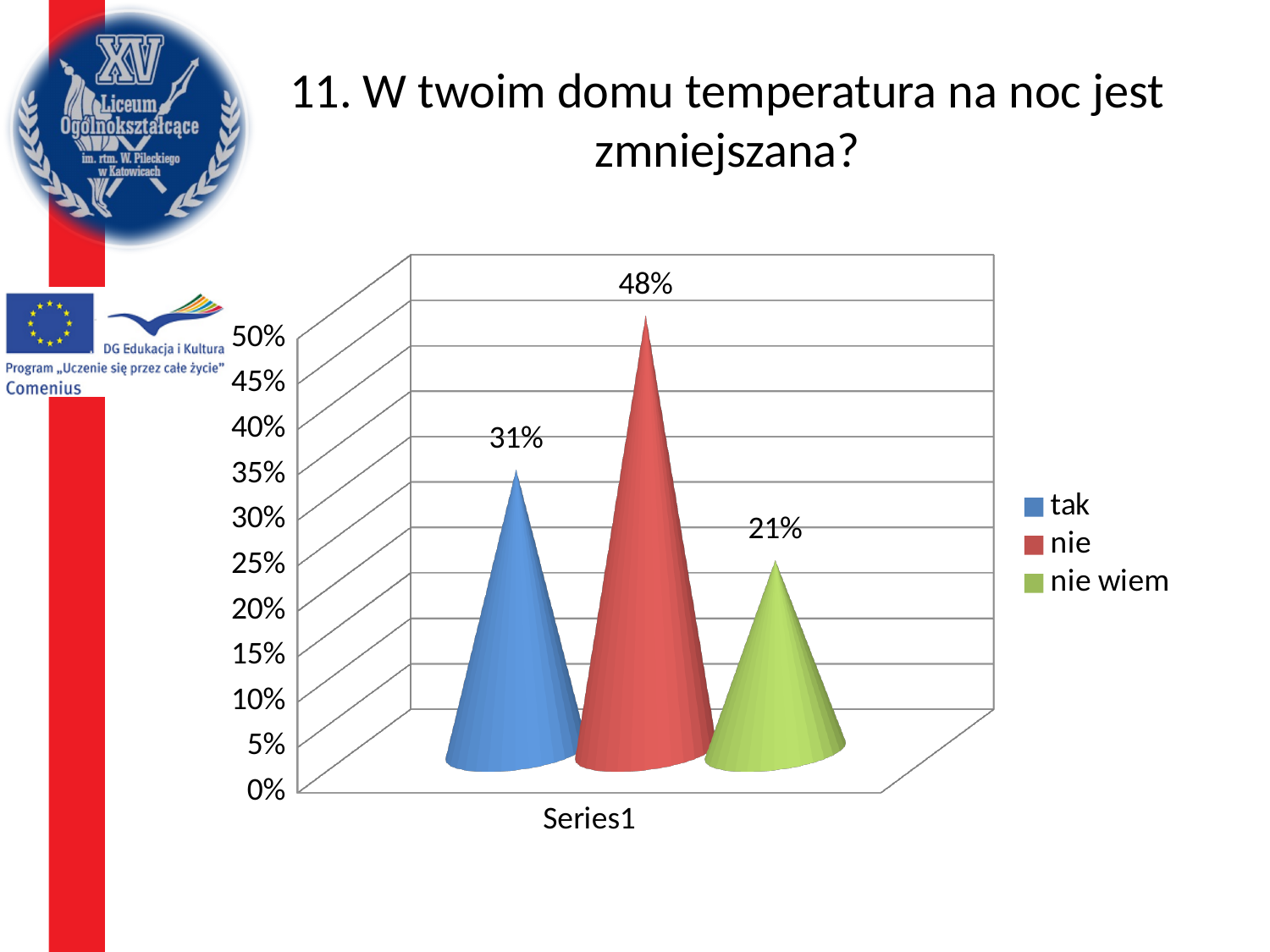
What is the difference between the values for "tak" and "nie wiem"? 10% What is the value for "tak"? 31% What is the value for "nie"? 48% Which answer has the lowest value? nie wiem What is the value for "nie wiem"? 21% Which is larger, the value for "tak" or the value for "nie wiem"? tak What kind of chart is shown on the slide? bar chart What colour is the cone for "nie"? red Is the value for "nie" greater or less than 40%? greater How many entries does the legend list? 3 Which answer has the highest value? nie What is the difference between the values for "nie" and "tak"? 17%